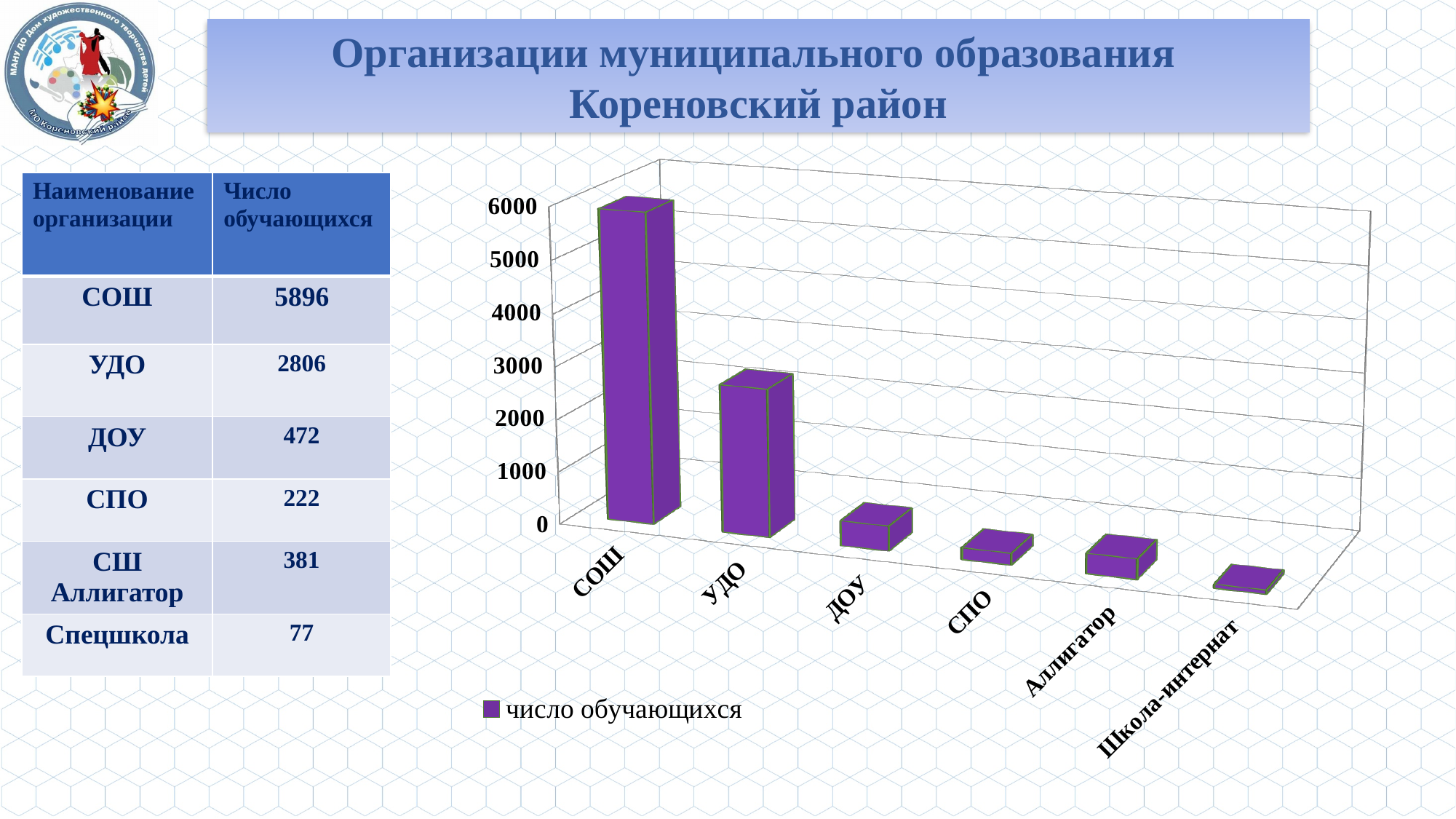
Is the value for УДО on the chart greater or less than 2000? greater According to the slide, what is the number of students (число обучающихся) for СОШ? 5896 Is the value for ДОУ on the chart greater or less than 1000? less Which category has the lowest bar on the chart? Школа-интернат What kind of chart is shown on the slide? bar chart How many categories are plotted on the chart? 6 According to the slide, what is the number of students (число обучающихся) for УДО? 2806 What is the name of the series shown in the chart legend? число обучающихся How many series does the chart legend list? 1 Which category has the highest bar on the chart? СОШ Which is larger on the chart, the value for СОШ or the value for УДО? СОШ What is the difference between the number of students for СОШ and for УДО, using the values printed on the slide? 3090